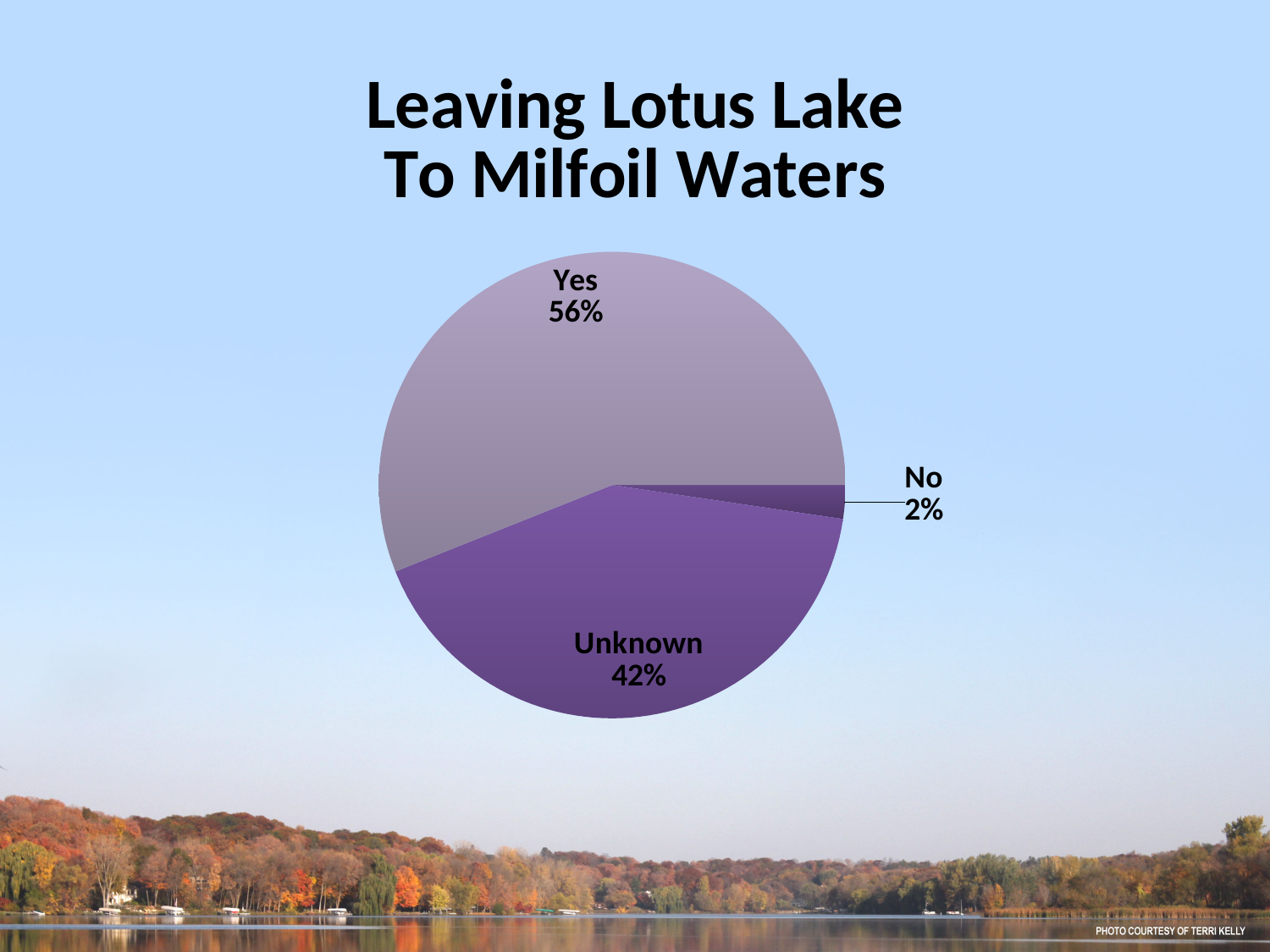
What share of the pie do the "Yes" and "Unknown" slices make up together? 98% Which is larger, the "Yes" slice or the "Unknown" slice? Yes What percentage of the pie is labelled "Yes"? 56% Which slice of the pie is the largest? Yes What percentage of the pie is labelled "Unknown"? 42% How many slices does the pie chart have? 3 What kind of chart is shown on the slide? pie chart Which slice of the pie is the smallest? No What is the difference in percentage points between the "Unknown" and "No" slices? 40 What percentage of the pie is labelled "No"? 2% What is the title of the chart? Leaving Lotus Lake To Milfoil Waters What is the difference in percentage points between the "Yes" and "Unknown" slices? 14